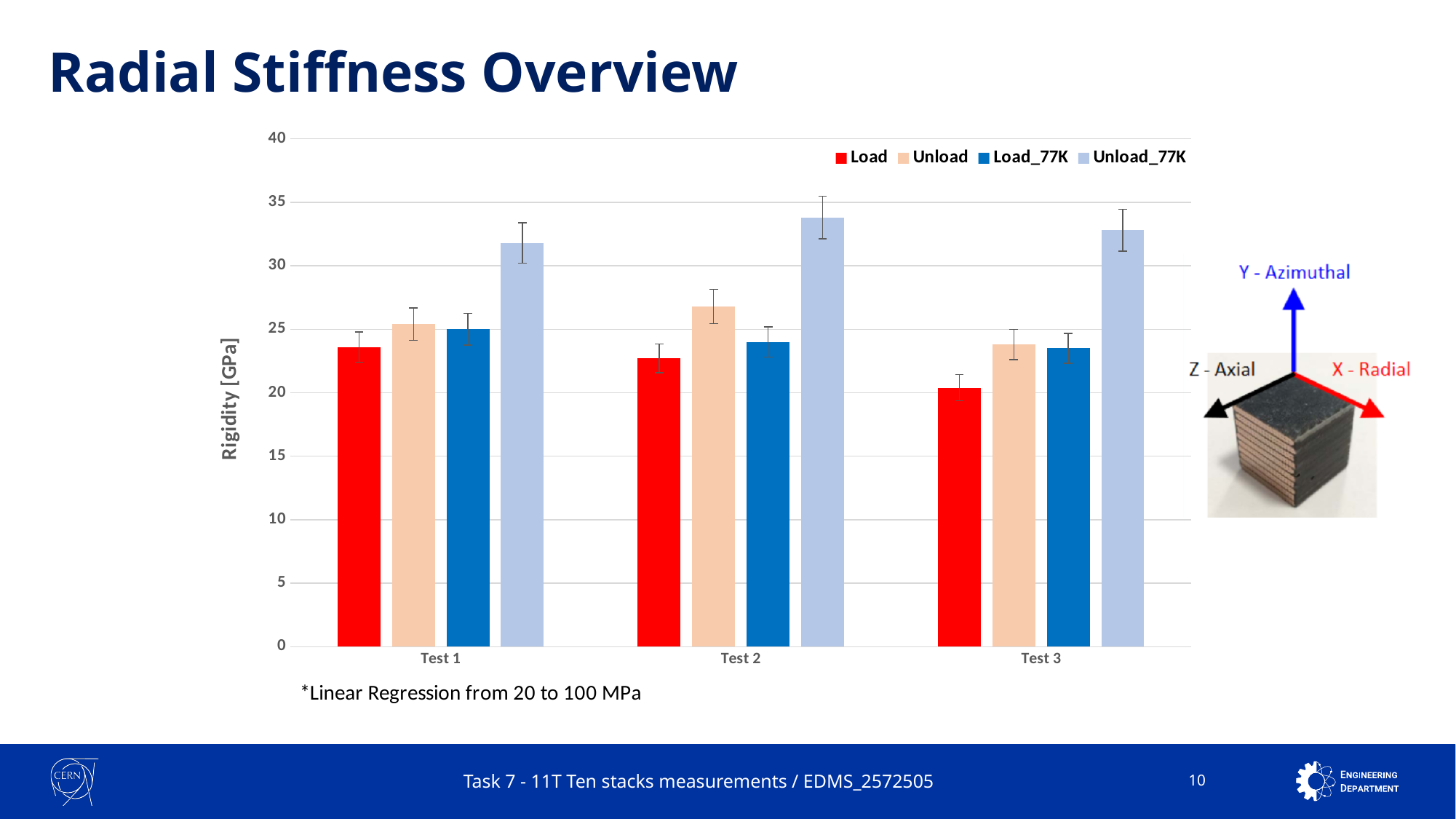
What is the label of the y axis? Rigidity [GPa] Which test has the lowest Load bar? Test 3 How many series does the legend list? 4 Is the Load value for Test 3 greater or less than 25? less What kind of chart is shown on the slide? bar chart How many test categories are shown on the x axis? 3 Which series has the lowest bar in Test 3? Load What colour represents the Load series in the legend? red Which series has the highest bar in Test 2? Unload_77K Is the Unload_77K value for Test 1 greater or less than 30? greater In Test 2, which is larger, the Load bar or the Unload bar? Unload Does the Load series rise or fall from Test 1 to Test 3? fall